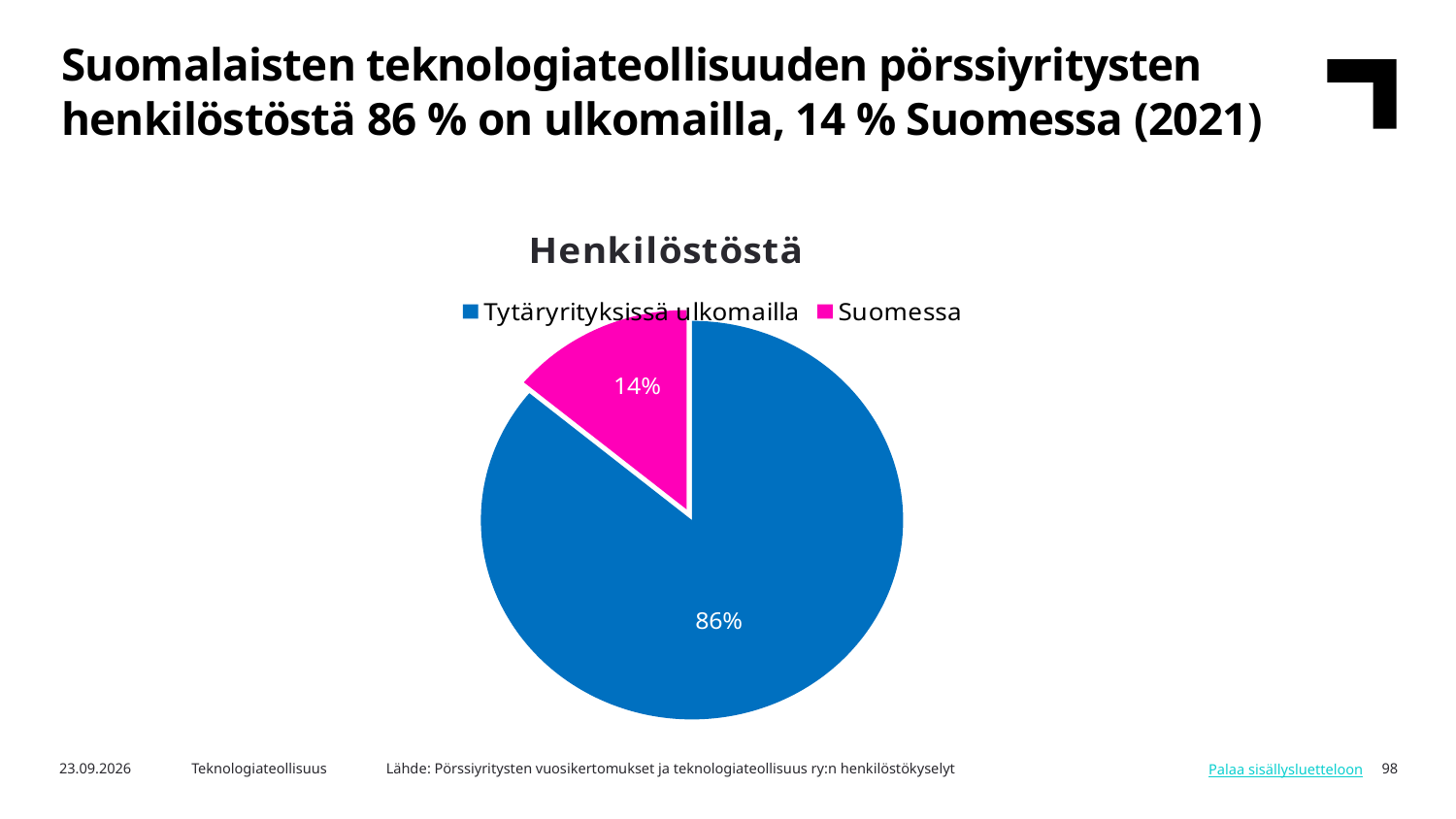
What kind of chart is shown on the slide? pie chart What is the difference in percentage points between the Tytäryrityksissä ulkomailla slice and the Suomessa slice? 72 Which slice is the largest? Tytäryrityksissä ulkomailla What share of the pie is labelled Tytäryrityksissä ulkomailla? 86% Which is larger, the Suomessa slice or the Tytäryrityksissä ulkomailla slice? Tytäryrityksissä ulkomailla What share of the pie is labelled Suomessa? 14% What is the chart's title? Henkilöstöstä Which slice is the smallest? Suomessa How many slices does the pie chart have? 2 What colour is the Suomessa slice? magenta How many entries does the legend list? 2